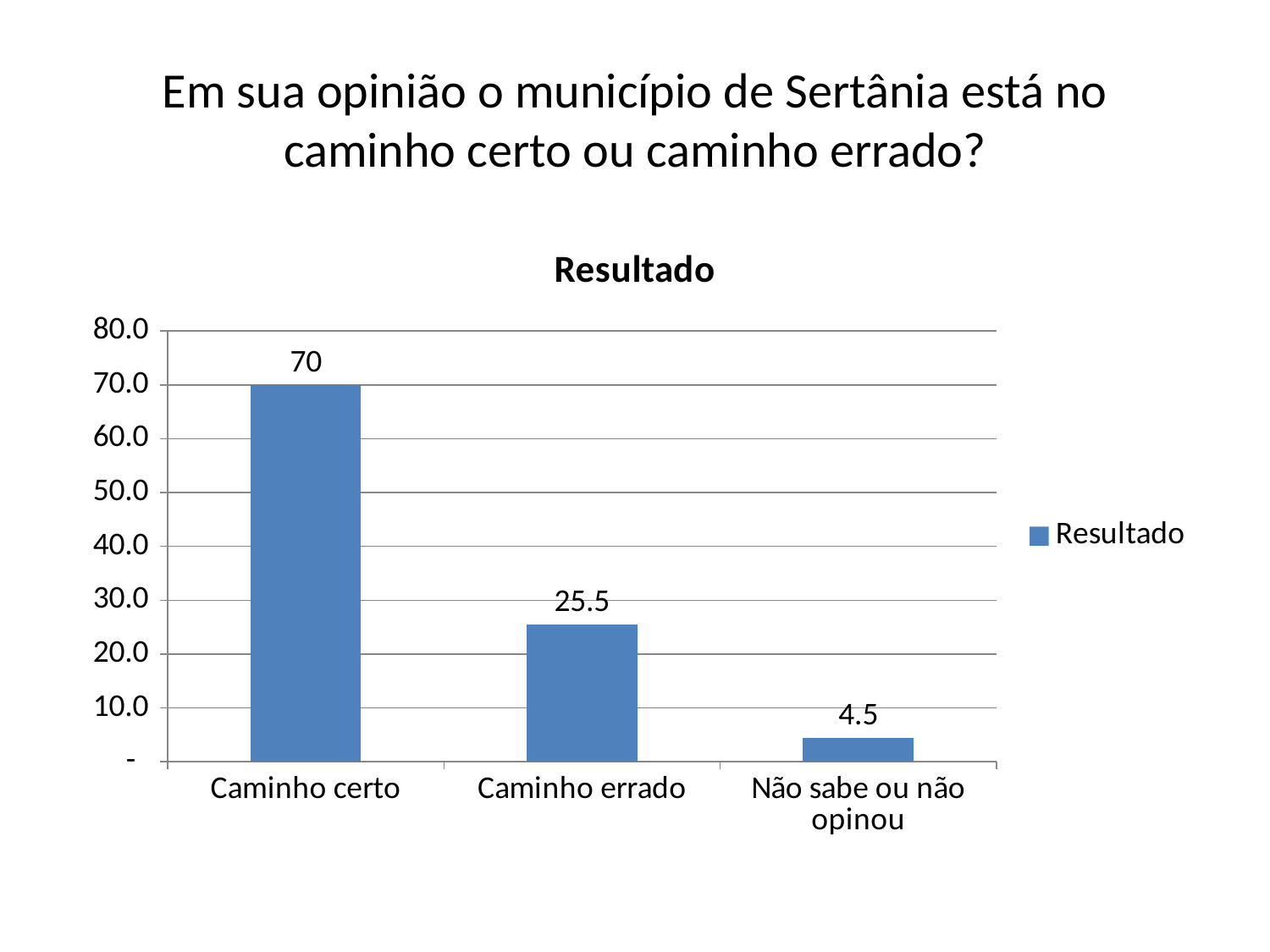
What is the value for Caminho certo? 70 How many series does the legend list? 1 What is the difference between the values for Caminho certo and Caminho errado? 44.5 Which category has the lowest value? Não sabe ou não opinou Which category has the highest value? Caminho certo Which is larger, the value for Caminho errado or the value for Não sabe ou não opinou? Caminho errado Is the value for Caminho errado greater or less than 30.0? less What is the value for Não sabe ou não opinou? 4.5 What is the value for Caminho errado? 25.5 What is the difference between the values for Caminho errado and Não sabe ou não opinou? 21 What kind of chart is shown on the slide? bar chart How many categories are shown on the x axis? 3